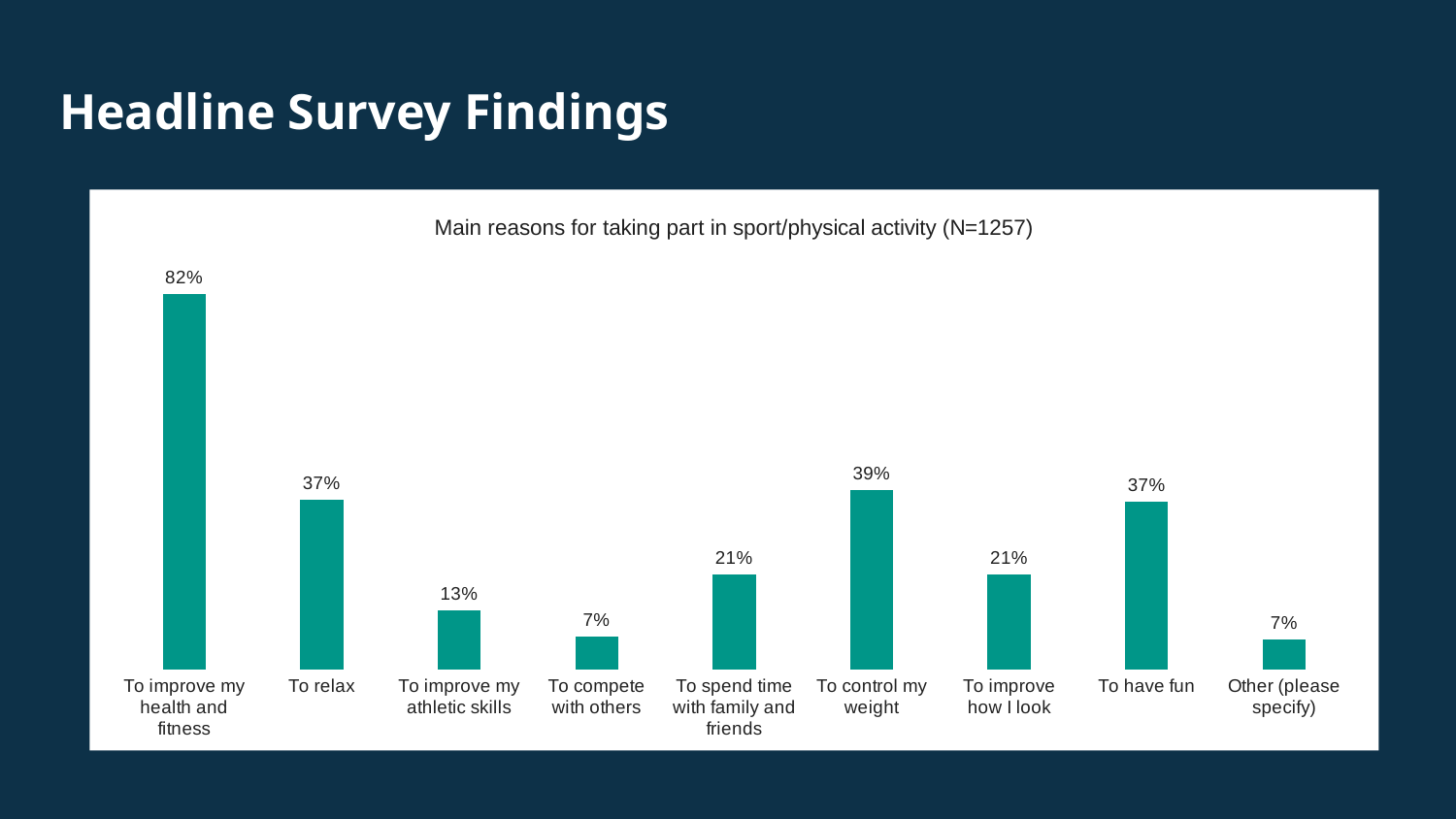
What is the sample size (N) stated in the chart title? 1257 What type of chart is shown on the slide? Bar chart What percentage is shown for 'To compete with others'? 7% What is the title of the chart? Main reasons for taking part in sport/physical activity (N=1257) What is the value shown for 'To control my weight'? 39% Which is larger: the value for 'To relax' or the value for 'To improve my athletic skills'? To relax Which two reasons share the lowest value of 7%? To compete with others; Other (please specify) What percentage of respondents gave 'To improve my health and fitness' as a main reason for taking part in sport/physical activity? 82% What is the difference in percentage points between 'To have fun' and 'To spend time with family and friends'? 16 How many reasons (categories) are shown on the x axis of the chart? 9 Which reason has the highest percentage in the chart? To improve my health and fitness What is the difference in percentage points between 'To improve my health and fitness' and 'To control my weight'? 43